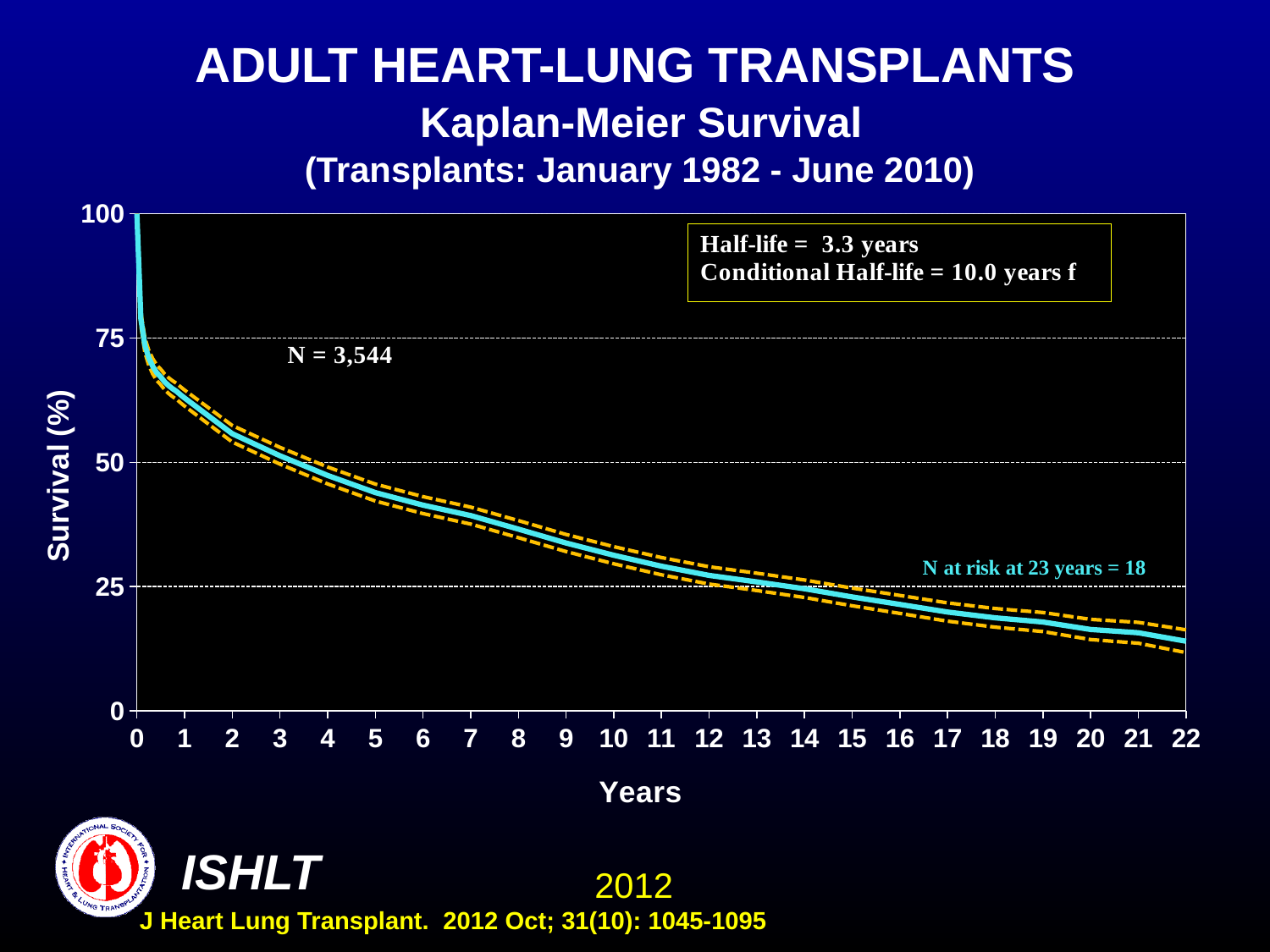
What is the label of the y axis? Survival (%) Is the survival value at 5 years greater or less than 50? less Is the survival value at 20 years greater or less than 25? less What is the value of N shown on the chart? 3,544 Is the survival value at 10 years greater or less than 25? greater What kind of chart is shown on the slide? line chart What half-life is reported on the chart? 3.3 years Does the survival curve rise or fall as years increase? fall What is the N at risk at 23 years according to the chart? 18 What conditional half-life is reported on the chart? 10.0 years